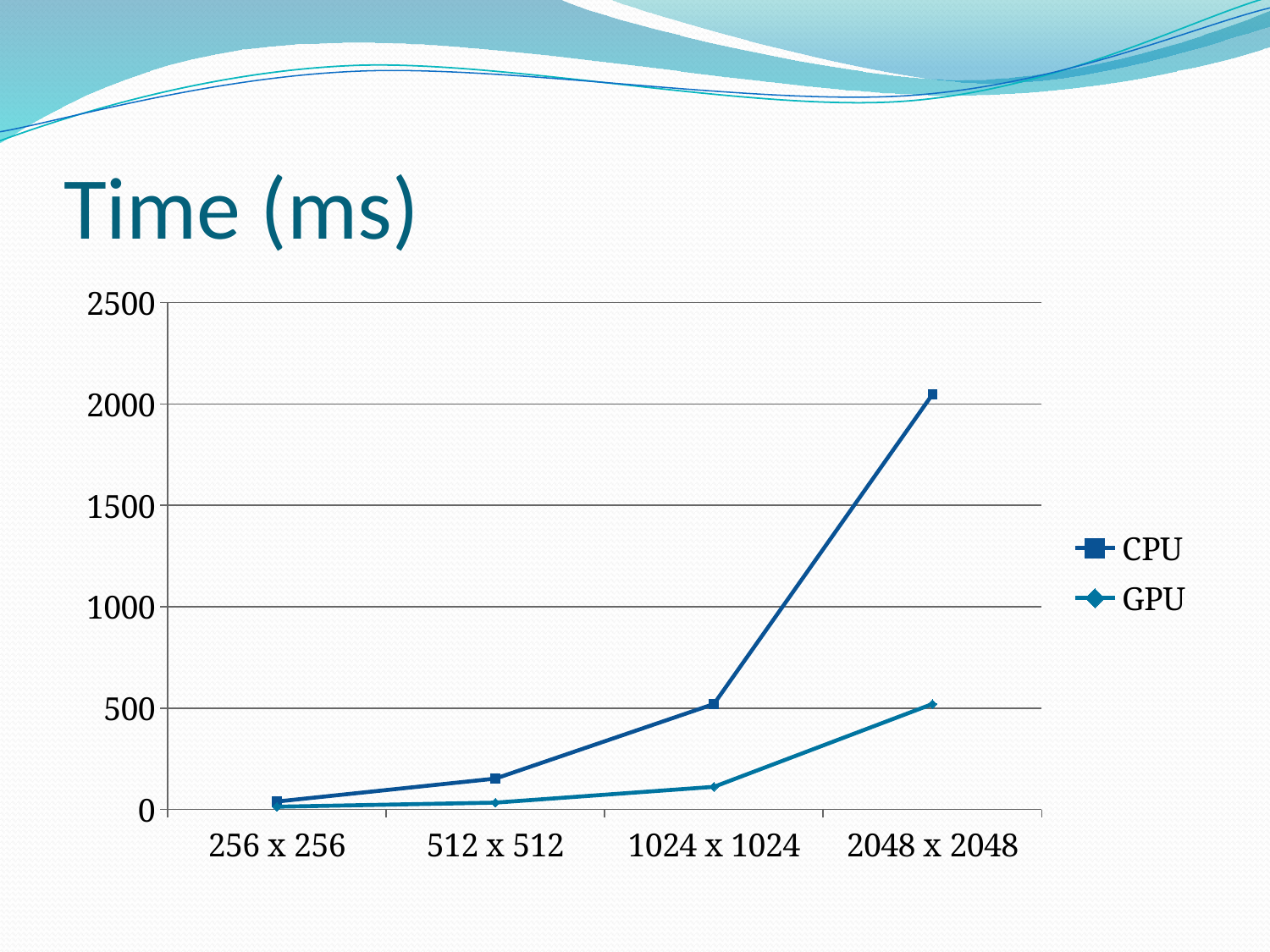
Do the CPU values rise or fall as the matrix size increases along the x axis? rise Is the CPU value for 512 x 512 greater or less than 500? less Which category has the lowest GPU value? 256 x 256 Which category has the highest CPU value? 2048 x 2048 How many categories are shown on the x axis? 4 How many series does the legend list? 2 What kind of chart is shown on the slide? line chart Is the CPU value for 1024 x 1024 greater or less than 1000? less Which is larger at 2048 x 2048, the CPU value or the GPU value? CPU What is the title of the chart? Time (ms) Is the GPU value for 2048 x 2048 greater or less than 1000? less